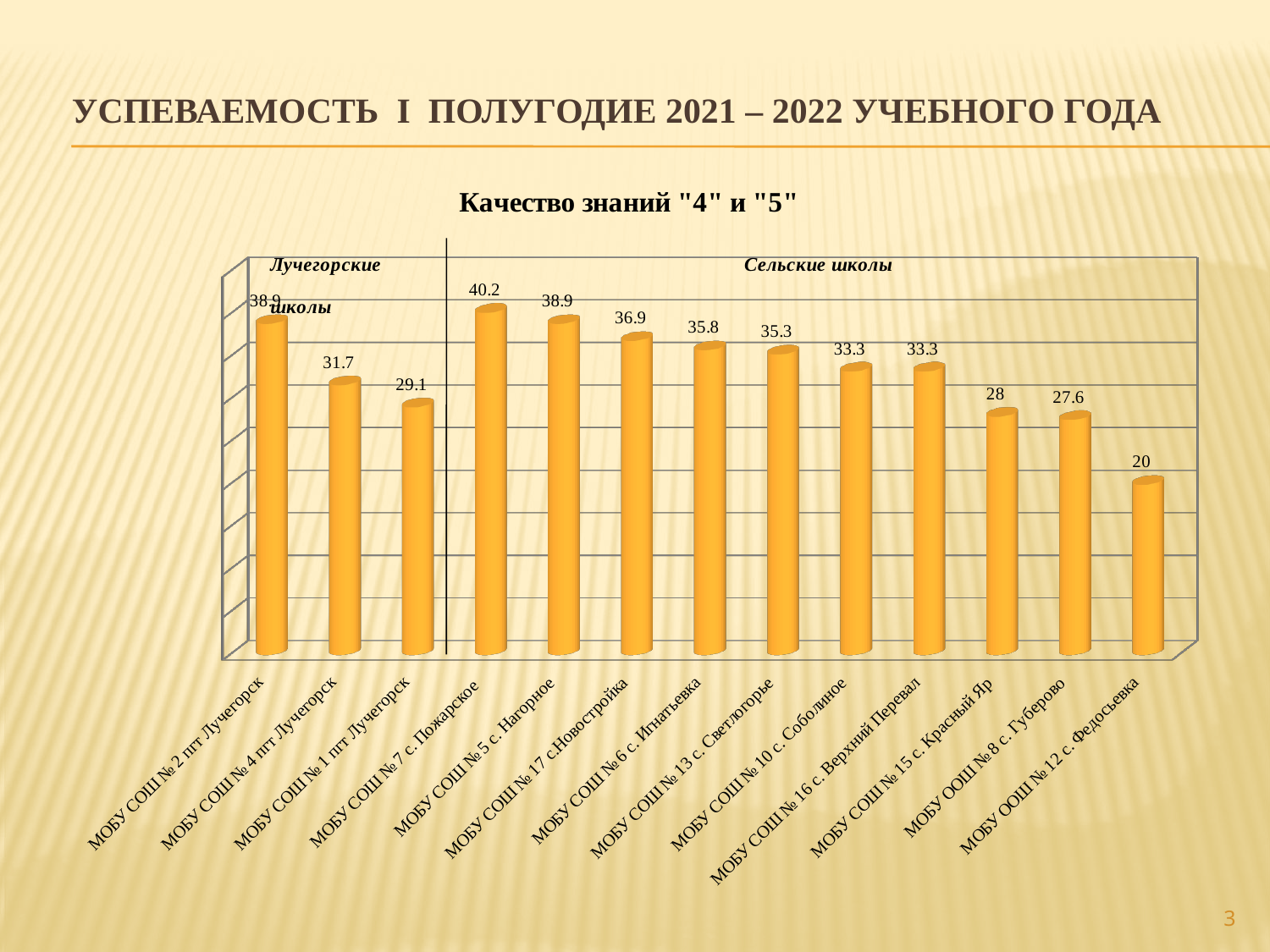
Which school has the lowest value in the chart? МОБУ ООШ № 12 с. Федосьевка What is the title of the chart? Качество знаний "4" и "5" How many schools (bars) are shown in the chart? 13 What is the value for МОБУ СОШ № 7 с. Пожарское? 40.2 Which school has the highest value in the chart? МОБУ СОШ № 7 с. Пожарское What is the difference between the values for МОБУ СОШ № 2 пгт Лучегорск and МОБУ СОШ № 4 пгт Лучегорск? 7.2 Into which two groups are the schools divided by the labels inside the chart? Лучегорские школы and Сельские школы Which has a larger value: МОБУ СОШ № 5 с. Нагорное or МОБУ СОШ № 17 с.Новостройка? МОБУ СОШ № 5 с. Нагорное What is the value for МОБУ ООШ № 8 с. Губерово? 27.6 What is the value for МОБУ СОШ № 4 пгт Лучегорск? 31.7 What kind of chart is shown on the slide? bar chart What is the difference between the values for МОБУ СОШ № 7 с. Пожарское and МОБУ ООШ № 12 с. Федосьевка? 20.2